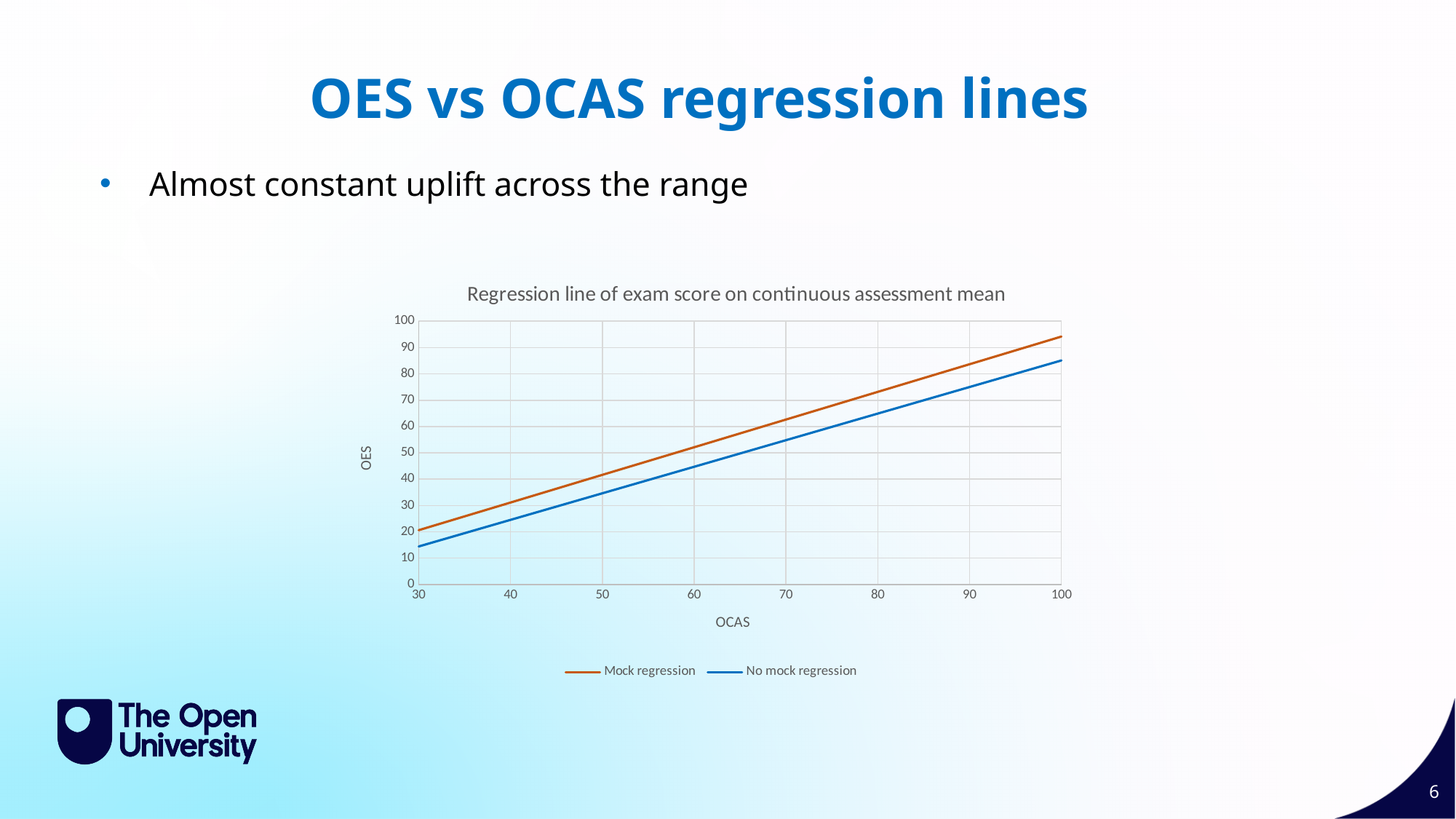
Is the Mock regression value at an OCAS of 100 greater or less than 90? greater Is the Mock regression value at an OCAS of 80 greater or less than 70? greater Do the OES values rise or fall as OCAS increases along the x axis? rise What is the title of the chart? Regression line of exam score on continuous assessment mean How many series does the chart legend list? 2 Is the No mock regression value at an OCAS of 100 greater or less than 90? less Which series is higher at an OCAS of 70, Mock regression or No mock regression? Mock regression What label is shown on the chart's x axis? OCAS What kind of chart is shown on the slide? line chart